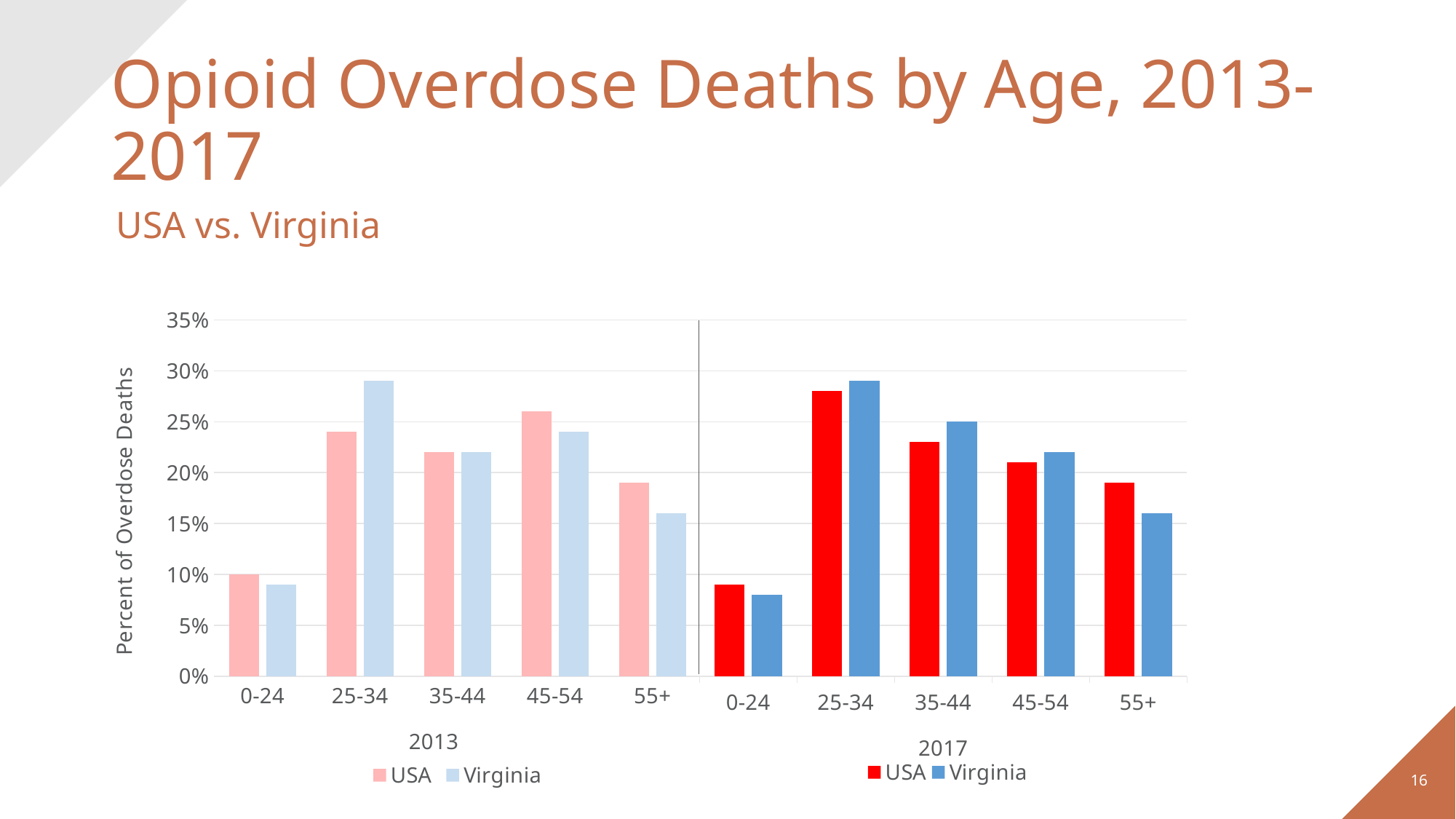
In the 2013 chart, for the 25-34 age group, which is larger: USA or Virginia? Virginia In the 2013 chart, which age group has the highest Virginia value? 25-34 In the 2017 chart, do the USA values rise or fall from the 25-34 group to the 55+ group? fall In the 2013 chart, which age group has the lowest USA value? 0-24 In the 2017 chart, which age group has the highest USA value? 25-34 What kind of chart is used on this slide? bar chart In the 2017 chart, is the USA value for 0-24 greater or less than 10%? less In the 2017 chart, which age group has the lowest Virginia value? 0-24 In the 2013 chart, how many age categories are shown on the x axis? 5 In the 2017 chart, how many series does the legend list? 2 In the 2017 chart, for the 55+ age group, which is larger: USA or Virginia? USA In the 2013 chart, is the Virginia value for 25-34 greater or less than 25%? greater